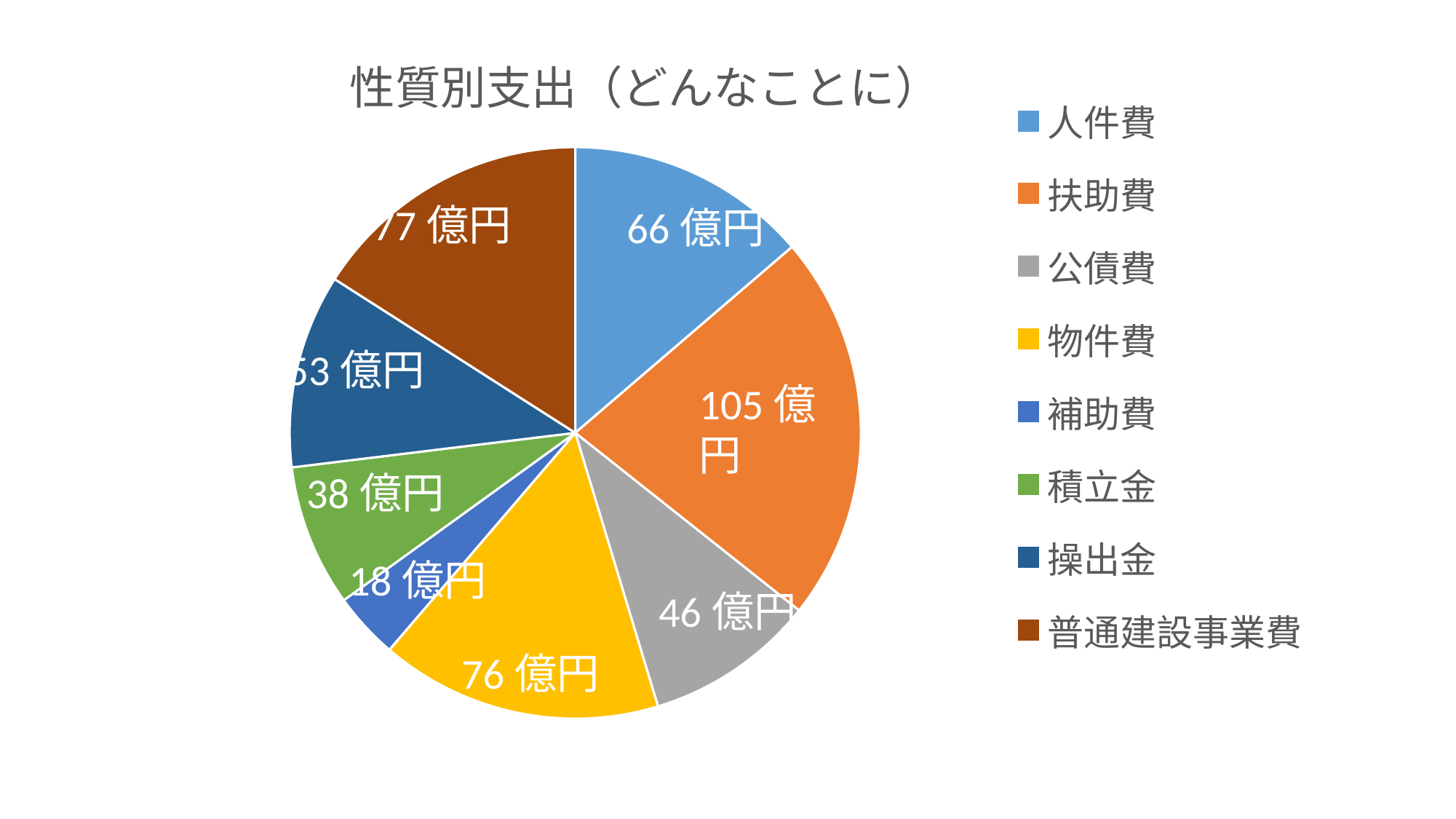
What is the value for 扶助費? 105 億円 Which category has the largest value? 扶助費 What is the difference between the values for 扶助費 and 人件費? 39 億円 What is the value for 補助費? 18 億円 What type of chart is shown on the slide? pie chart What is the value for 公債費? 46 億円 What is the value for 人件費? 66 億円 What is the value for 積立金? 38 億円 What is the value for 物件費? 76 億円 How many categories (slices) does the pie chart have? 8 What is the title of the chart? 性質別支出（どんなことに） Which category has the smallest value? 補助費